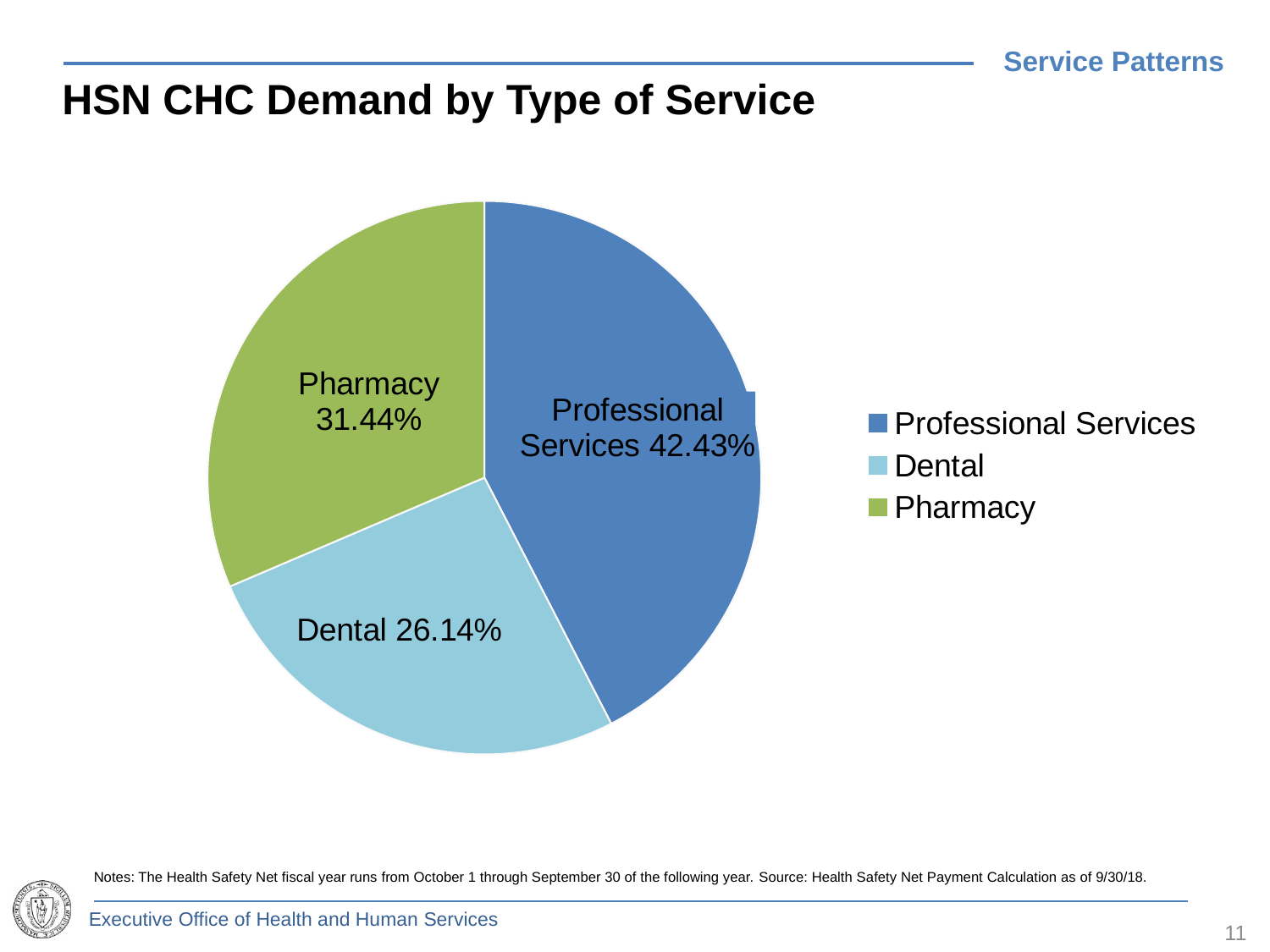
What kind of chart is shown on the slide? Pie chart Which type of service has the largest share of HSN CHC demand? Professional Services What is the difference in percentage points between the Professional Services share and the Dental share? 16.29 Which type of service has the smallest share of HSN CHC demand? Dental How many entries does the legend list? 3 Which has a larger share of HSN CHC demand, Pharmacy or Dental? Pharmacy What share of HSN CHC demand is Pharmacy? 31.44% How many slices does the pie chart have? 3 What is the difference in percentage points between the Pharmacy share and the Dental share? 5.30 What share of HSN CHC demand is Dental? 26.14% What share of HSN CHC demand is Professional Services? 42.43% What is the title of the chart? HSN CHC Demand by Type of Service